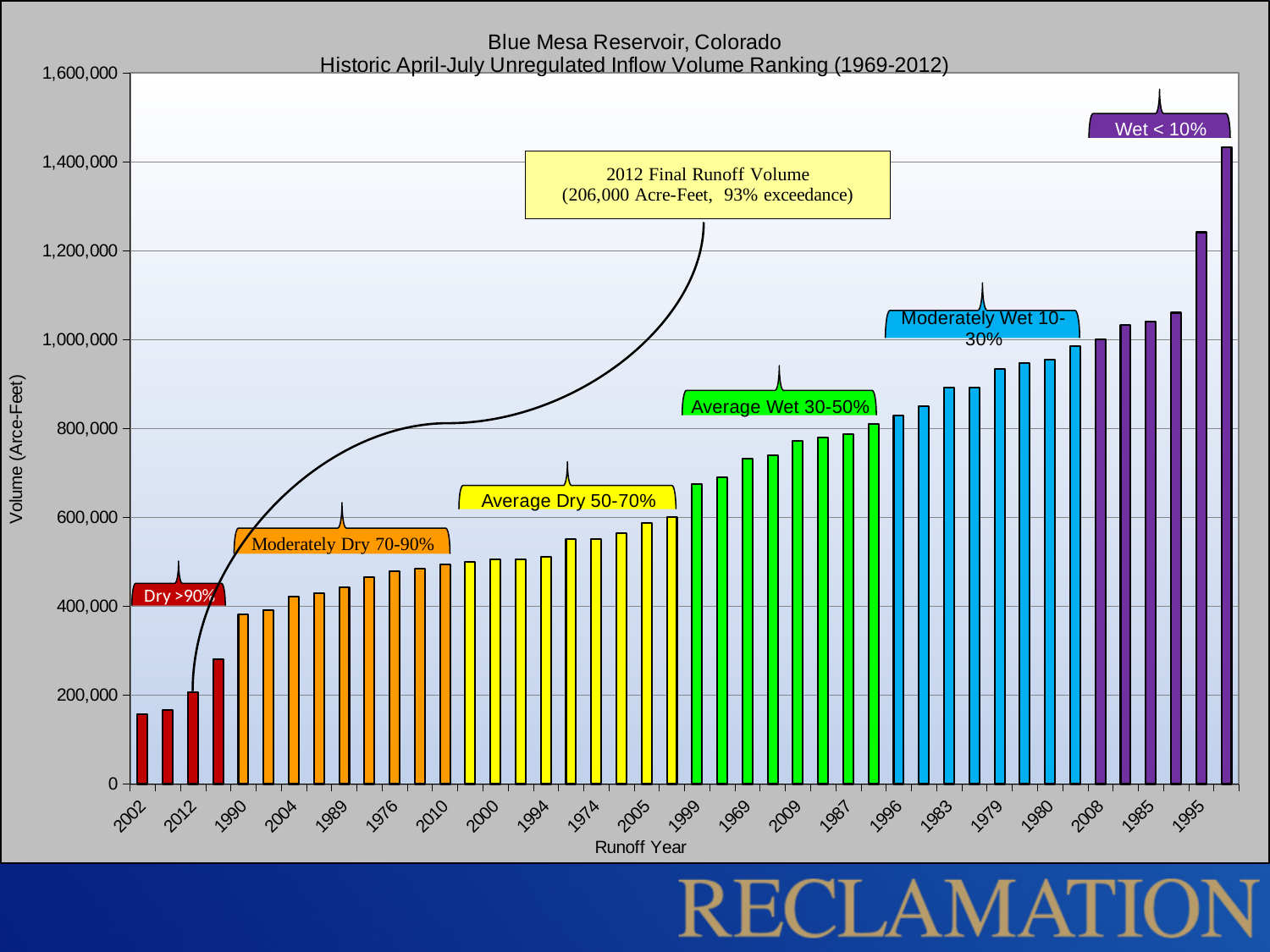
What exceedance percentage is given for the 2012 final runoff volume? 93% What is the label of the y axis? Volume (Arce-Feet) Do the bar values rise or fall from left to right along the x axis? rise Is the value for 1990 greater or less than 400,000? less Which labeled runoff year has the lowest inflow volume? 2002 What kind of chart is shown on the slide? bar chart What is the 2012 final runoff volume stated in the annotation box? 206,000 Acre-Feet Is the value for 2002 greater or less than 200,000? less Is the value for 1995 greater or less than 1,200,000? greater Which has a larger inflow volume, 1995 or 2002? 1995